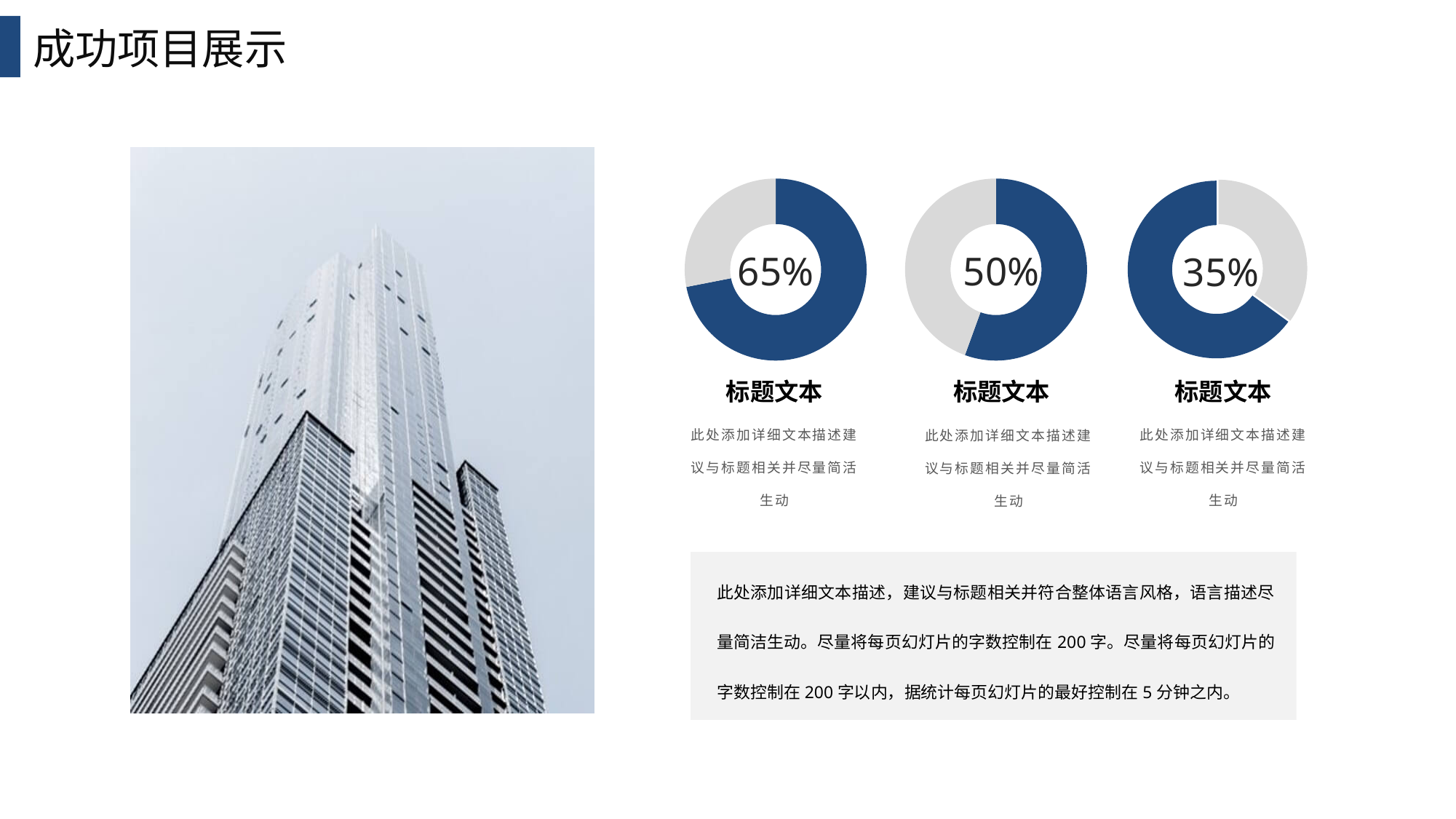
Which shows a larger percentage, the middle donut chart or the right donut chart? The middle donut chart What percentage is shown in the centre of the left donut chart? 65% How many donut charts are on the slide? 3 What is the difference between the percentage in the left donut chart and the percentage in the right donut chart? 30 percentage points Which of the three donut charts shows the highest percentage? The left one (65%) What percentage is shown in the centre of the middle donut chart? 50% Which of the three donut charts shows the lowest percentage? The right one (35%) Is the percentage shown in the left donut chart greater or less than 50%? greater What kind of chart is used to display the three percentages on the slide? Donut (pie) chart What two colours are used for the segments of the donut charts? Blue and grey What percentage is shown in the centre of the right donut chart? 35% What is the difference between the percentage in the left donut chart and the percentage in the middle donut chart? 15 percentage points